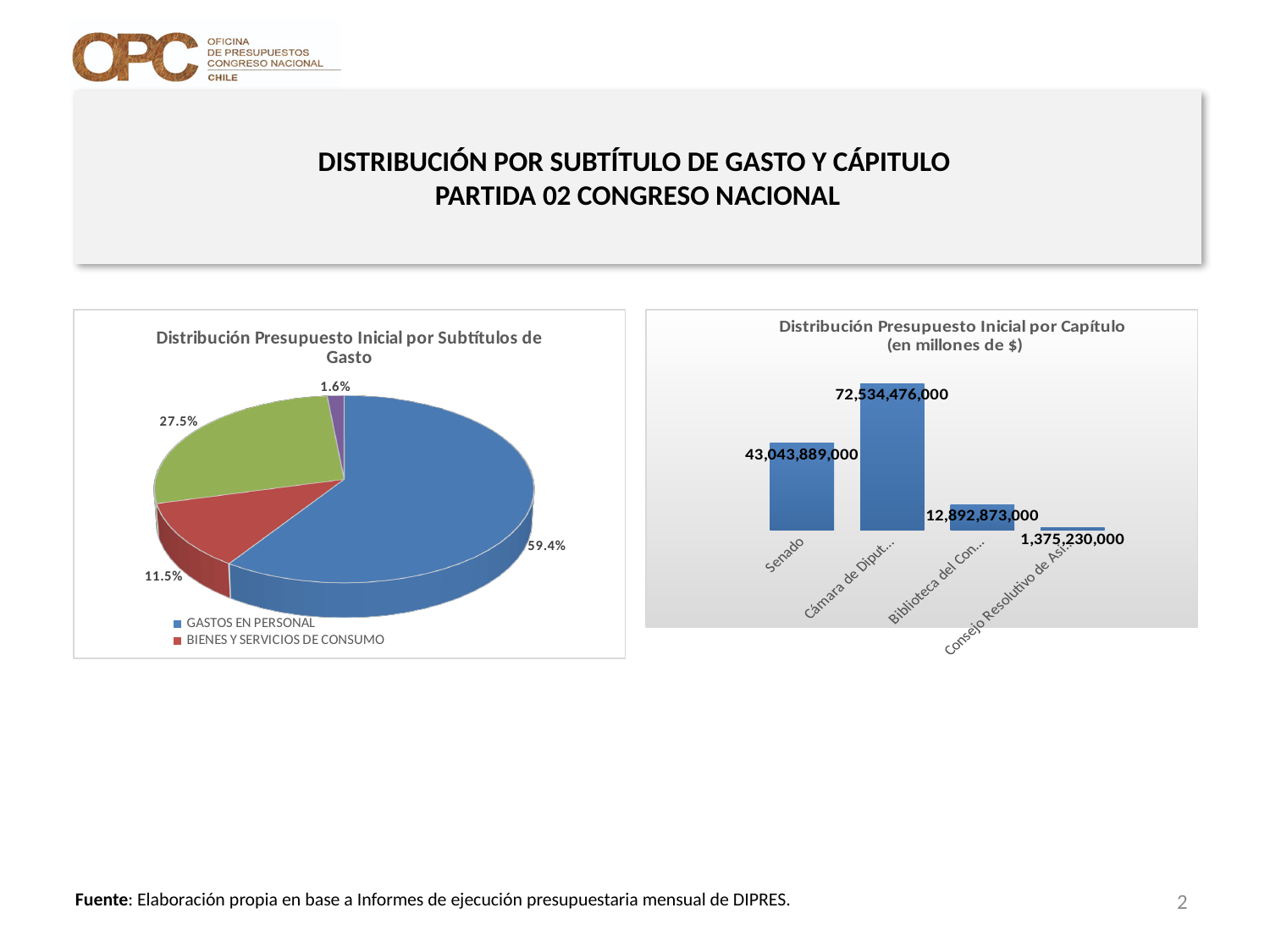
How many entries does the legend of the pie chart on the left list? 2 In the pie chart on the left, what is the percentage of the smallest slice? 1.6% In the pie chart on the left, how many percentage points larger is GASTOS EN PERSONAL than BIENES Y SERVICIOS DE CONSUMO? 47.9 percentage points What kind of chart is 'Distribución Presupuesto Inicial por Capítulo' on the right? Bar chart In the chart 'Distribución Presupuesto Inicial por Capítulo', what is the value for Senado? 43,043,889,000 In the pie chart on the left, which legend category has the largest slice? GASTOS EN PERSONAL In the chart 'Distribución Presupuesto Inicial por Capítulo', what is the value of the highest bar? 72,534,476,000 In the pie chart 'Distribución Presupuesto Inicial por Subtítulos de Gasto', what share is shown for BIENES Y SERVICIOS DE CONSUMO? 11.5% In the pie chart 'Distribución Presupuesto Inicial por Subtítulos de Gasto', what share is shown for GASTOS EN PERSONAL? 59.4% In the chart 'Distribución Presupuesto Inicial por Capítulo', what is the value of the lowest bar? 1,375,230,000 How many slices does the pie chart on the left have? 4 In the chart 'Distribución Presupuesto Inicial por Capítulo', how many bars are plotted? 4